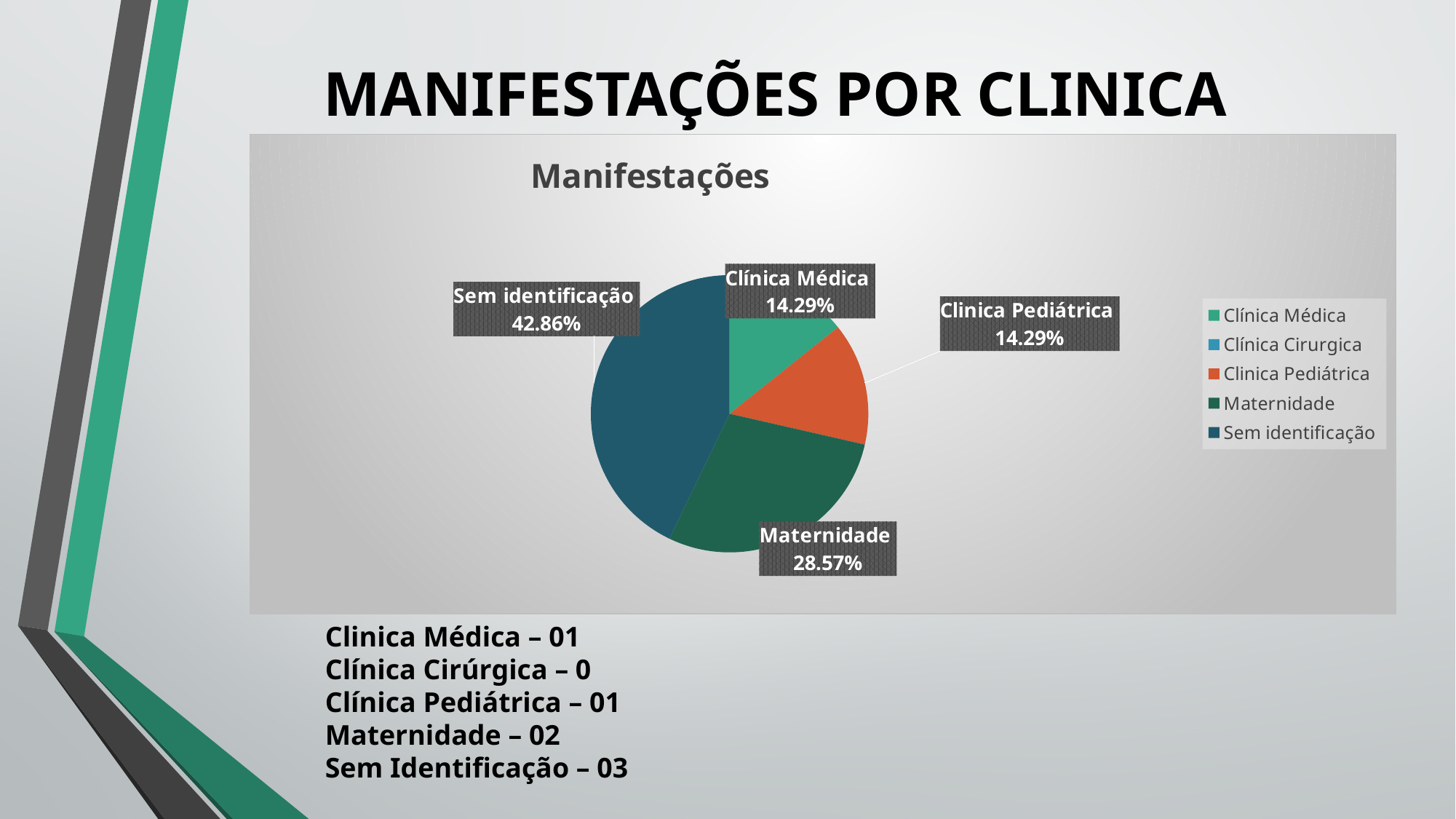
What share of the pie does Sem identificação have? 42.86% How many slices with data labels are visible in the pie? 4 Which legend entry has no visible slice in the pie? Clínica Cirurgica Which category has the largest slice of the pie? Sem identificação What is the title of the chart? Manifestações What kind of chart is shown on the slide? pie chart What share of the pie does Clinica Pediátrica have? 14.29% Which is larger, the slice for Maternidade or the slice for Clinica Pediátrica? Maternidade What share of the pie does Maternidade have? 28.57% What is the difference in percentage points between the Sem identificação slice and the Maternidade slice? 14.29 How many entries does the legend list? 5